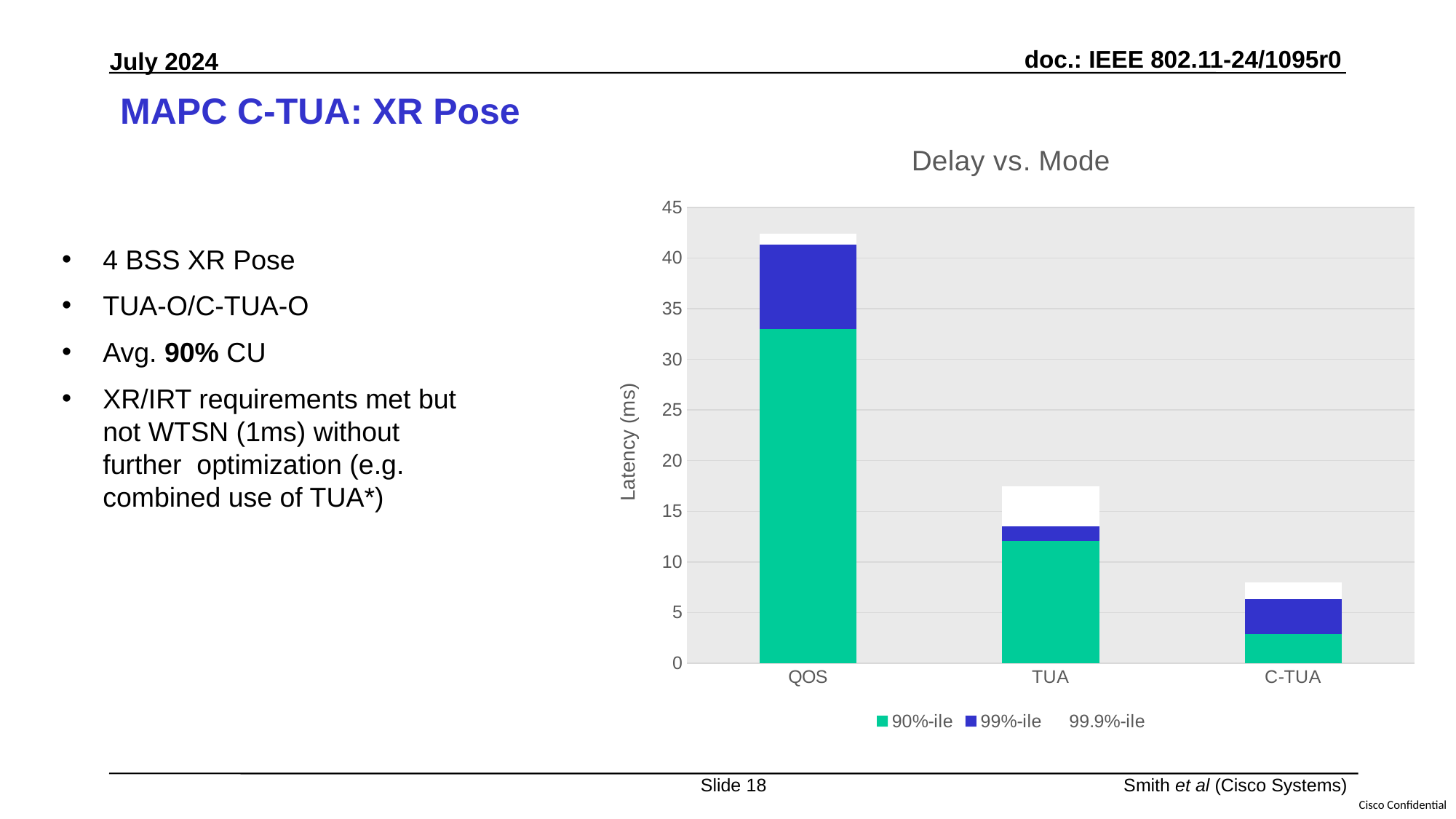
What is the title of the chart? Delay vs. Mode Do the total latencies rise or fall moving from QOS to C-TUA along the x axis? fall Is the total stacked latency for C-TUA greater or less than 10 ms? less Which mode has the lowest total latency? C-TUA How many modes (categories) are shown on the x axis? 3 Is the 90%-ile latency for TUA greater or less than 10 ms? greater Which mode has the highest total latency? QOS How many series does the chart legend list? 3 Is the 90%-ile latency for QOS greater or less than 30 ms? greater What kind of chart is shown on the slide? Stacked bar chart Which has the larger 90%-ile latency, TUA or C-TUA? TUA